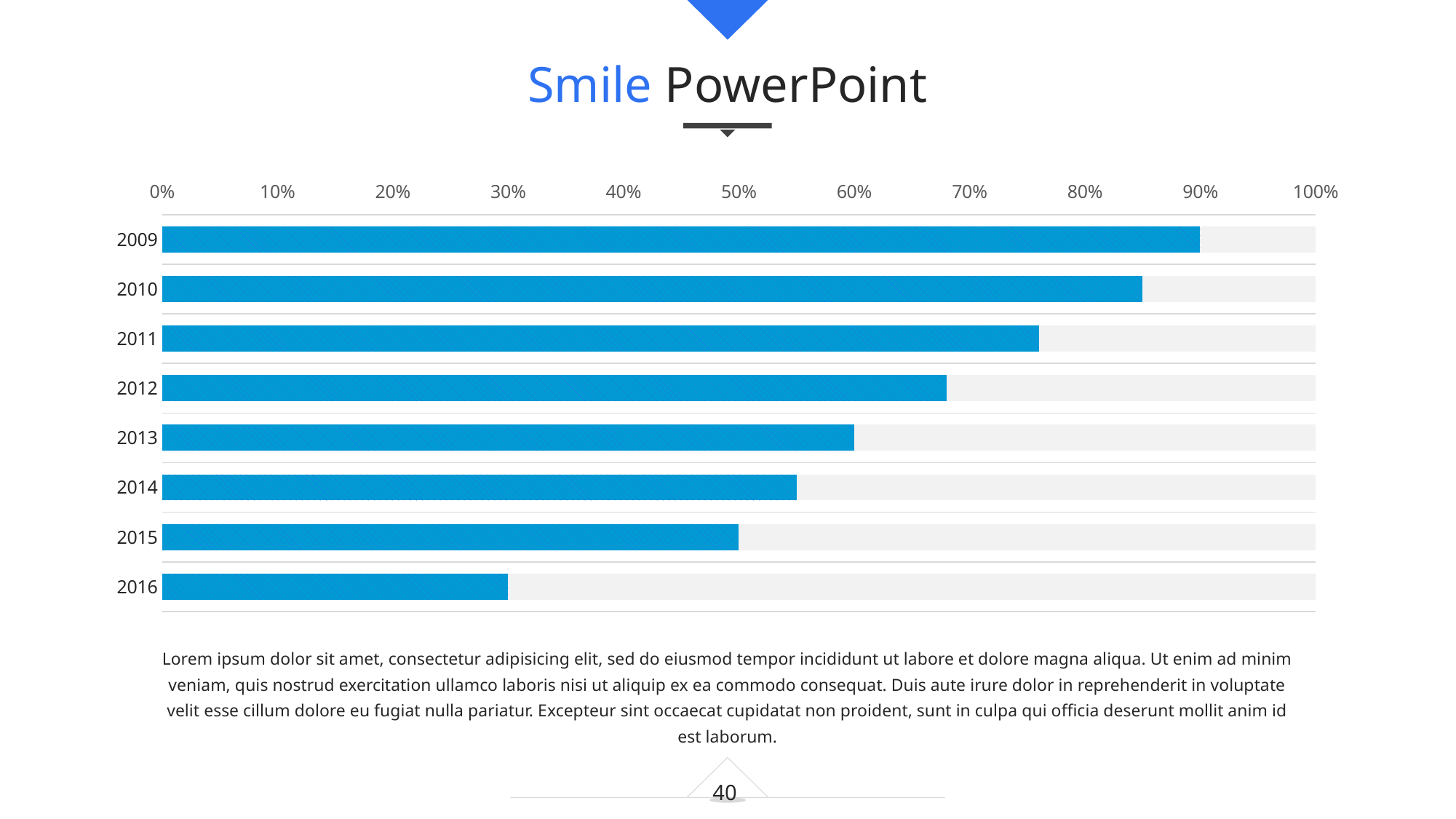
What kind of chart is shown on the slide? bar chart Which year has the lowest value in the chart? 2016 Is the value for 2010 greater or less than 80%? greater Is the value for 2014 greater or less than 50%? greater Do the values rise or fall from 2009 to 2016? fall How many years are plotted in the chart? 8 Is the value for 2012 greater or less than 70%? less What is the value for 2016? 30% Which year has the highest value in the chart? 2009 Which is larger, the value for 2011 or the value for 2014? 2011 What is the first year listed on the vertical axis of the chart? 2009